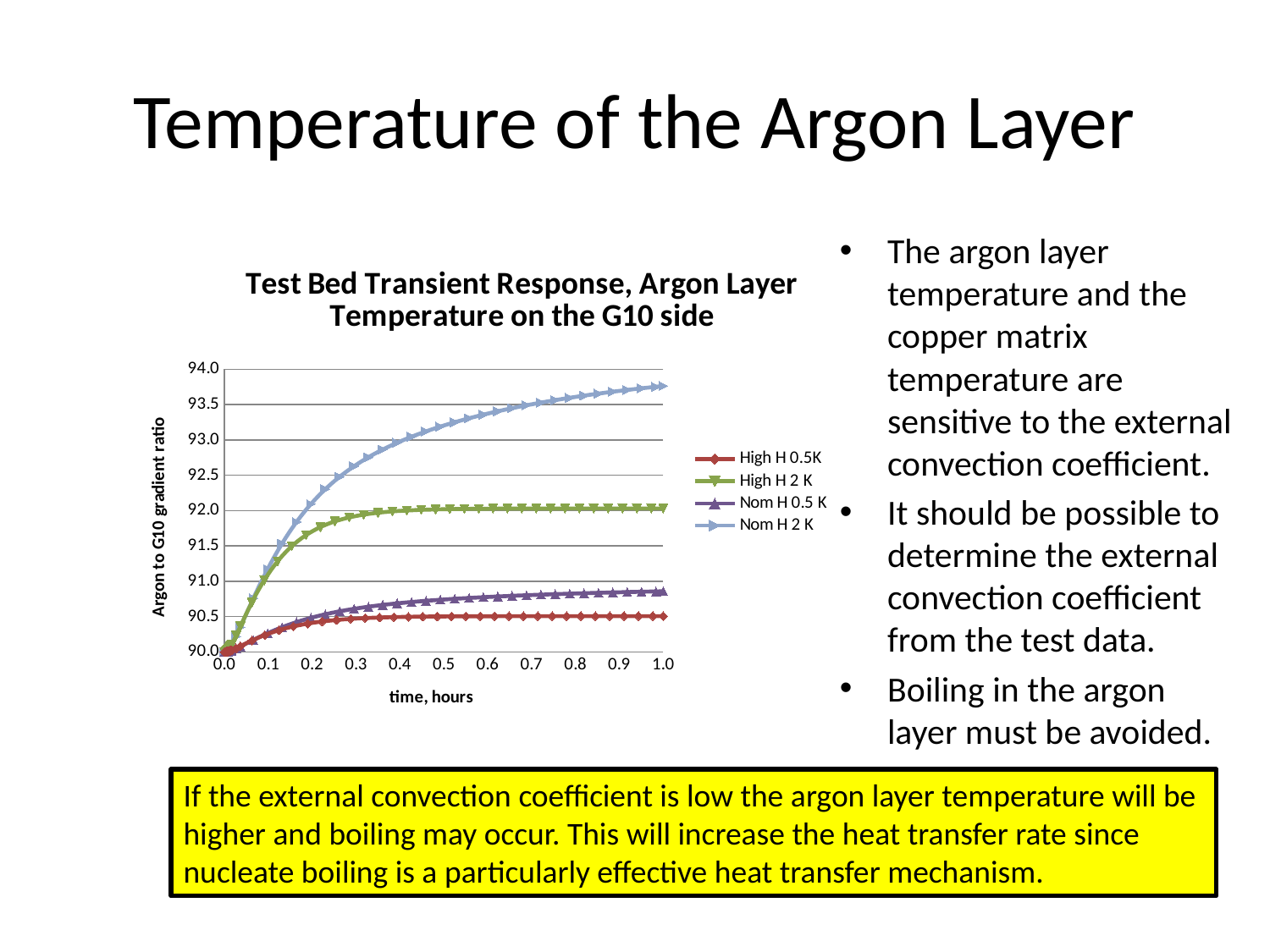
Do the values for Nom H 2 K rise or fall as time increases from 0.0 to 1.0 hours? rise Is the value for High H 2 K at 1.0 hours greater or less than 92.5? less Is the value for Nom H 2 K at 1.0 hours greater or less than 93.5? greater Which series has the highest value at 1.0 hours? Nom H 2 K What is the label of the x axis of the chart? time, hours What kind of chart is shown on the slide? line chart Which series has the larger value at 0.5 hours, Nom H 2 K or High H 2 K? Nom H 2 K Is the value for Nom H 0.5 K at 1.0 hours greater or less than 90.5? greater Which series has the lowest value at 1.0 hours? High H 0.5K How many series does the chart legend list? 4 What is the title of the chart? Test Bed Transient Response, Argon Layer Temperature on the G10 side